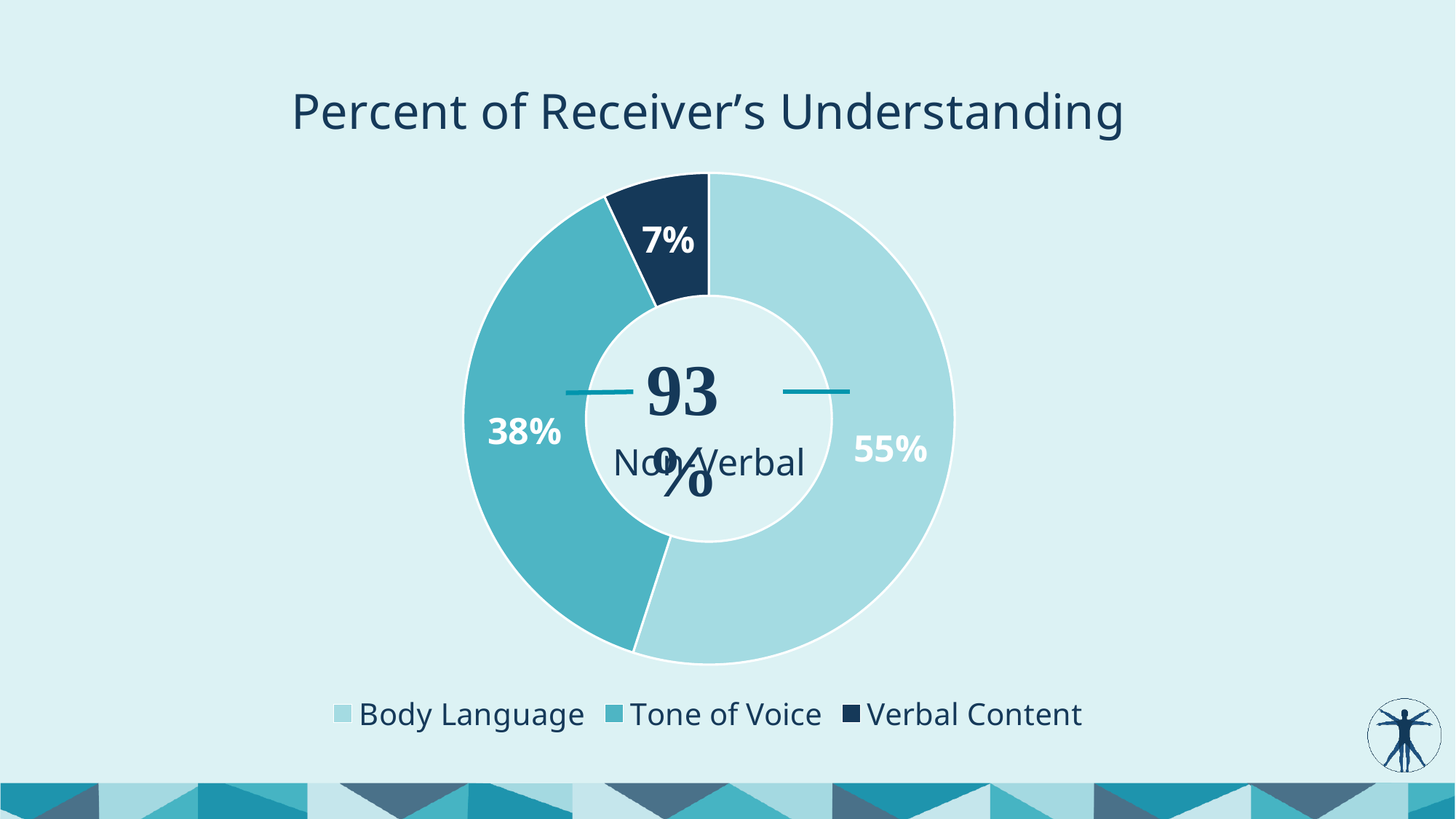
What percentage is shown for Tone of Voice? 38% How many categories does the legend list? 3 Which category has the largest share? Body Language Which category has the smallest share? Verbal Content What is the difference in percentage points between Body Language and Tone of Voice? 17 What is the combined share of Body Language and Tone of Voice? 93% What text is shown in the centre of the doughnut chart? 93% Non-Verbal What is the title of the chart? Percent of Receiver's Understanding What kind of chart is shown on the slide? Doughnut chart What percentage is shown for Body Language? 55% Which is larger, the share for Tone of Voice or the share for Verbal Content? Tone of Voice What percentage is shown for Verbal Content? 7%